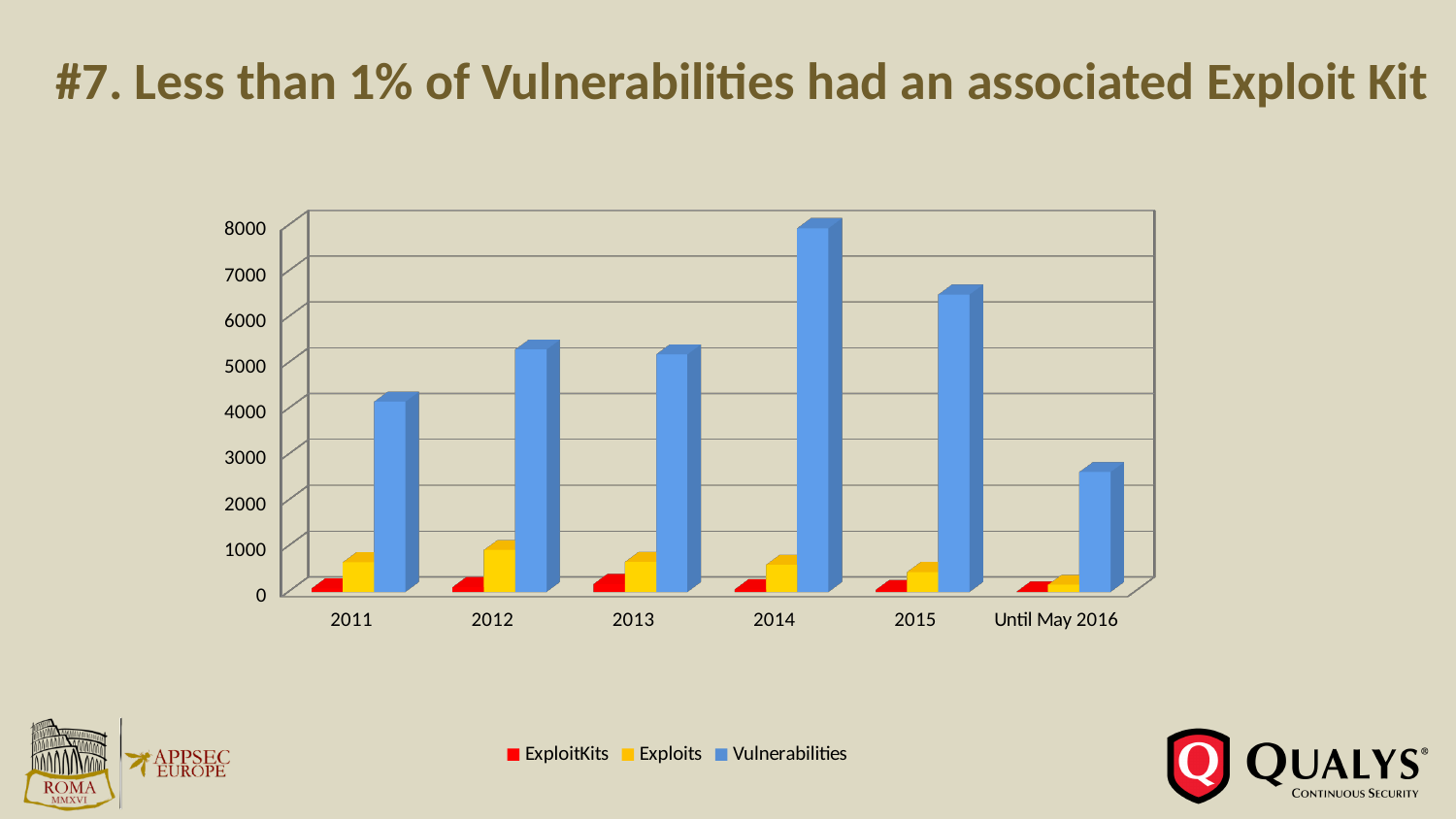
In which year is the Vulnerabilities bar the highest? 2014 Which is larger, the Vulnerabilities value for 2014 or for 2015? 2014 Which series has the tallest bar in every category of the chart? Vulnerabilities In which category is the Vulnerabilities bar the lowest? Until May 2016 Is the Vulnerabilities value for 2015 greater or less than 6000? greater How many categories are shown along the x axis of the chart? 6 Is the Vulnerabilities value for 2014 greater or less than 7000? greater Is the Vulnerabilities value for Until May 2016 greater or less than 3000? less Which series is shown in red in the chart's legend? ExploitKits What kind of chart is shown on the slide? Bar chart How many series does the chart's legend list? 3